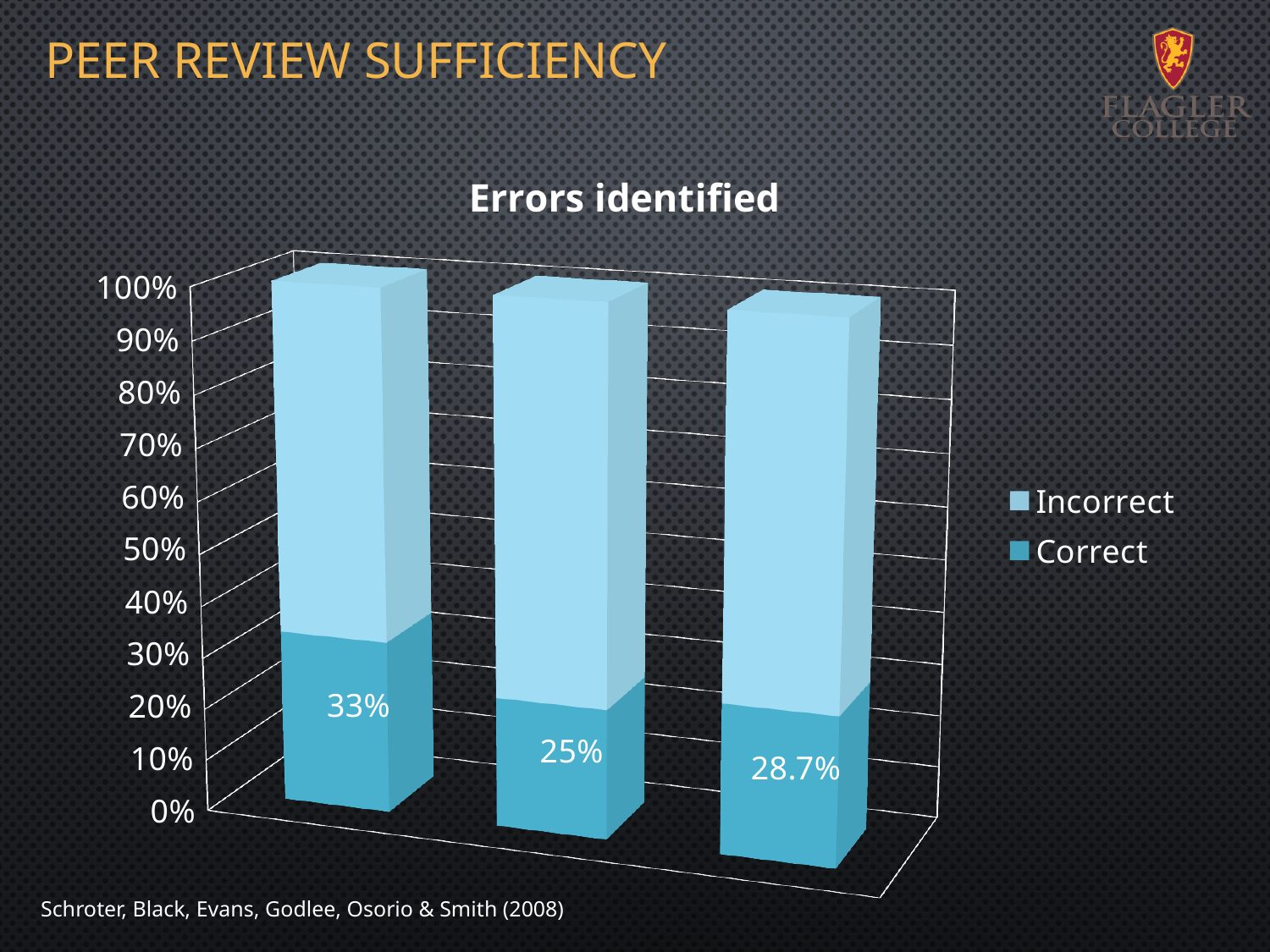
How many bars are plotted in the chart? 3 What is the difference between the Correct values of the leftmost bar and the middle bar? 8% What is the Correct value for the leftmost bar? 33% What is the Correct value for the rightmost bar? 28.7% Which bar has the lowest Correct value? The middle bar What is the title of the chart? Errors identified What is the Correct value for the middle bar? 25% How many series does the legend list? 2 Is the Incorrect portion of the leftmost bar greater or less than 50%? greater Which has a larger Correct value, the leftmost bar or the rightmost bar? The leftmost bar Which bar has the highest Correct value? The leftmost bar What kind of chart is shown on the slide? Stacked bar chart